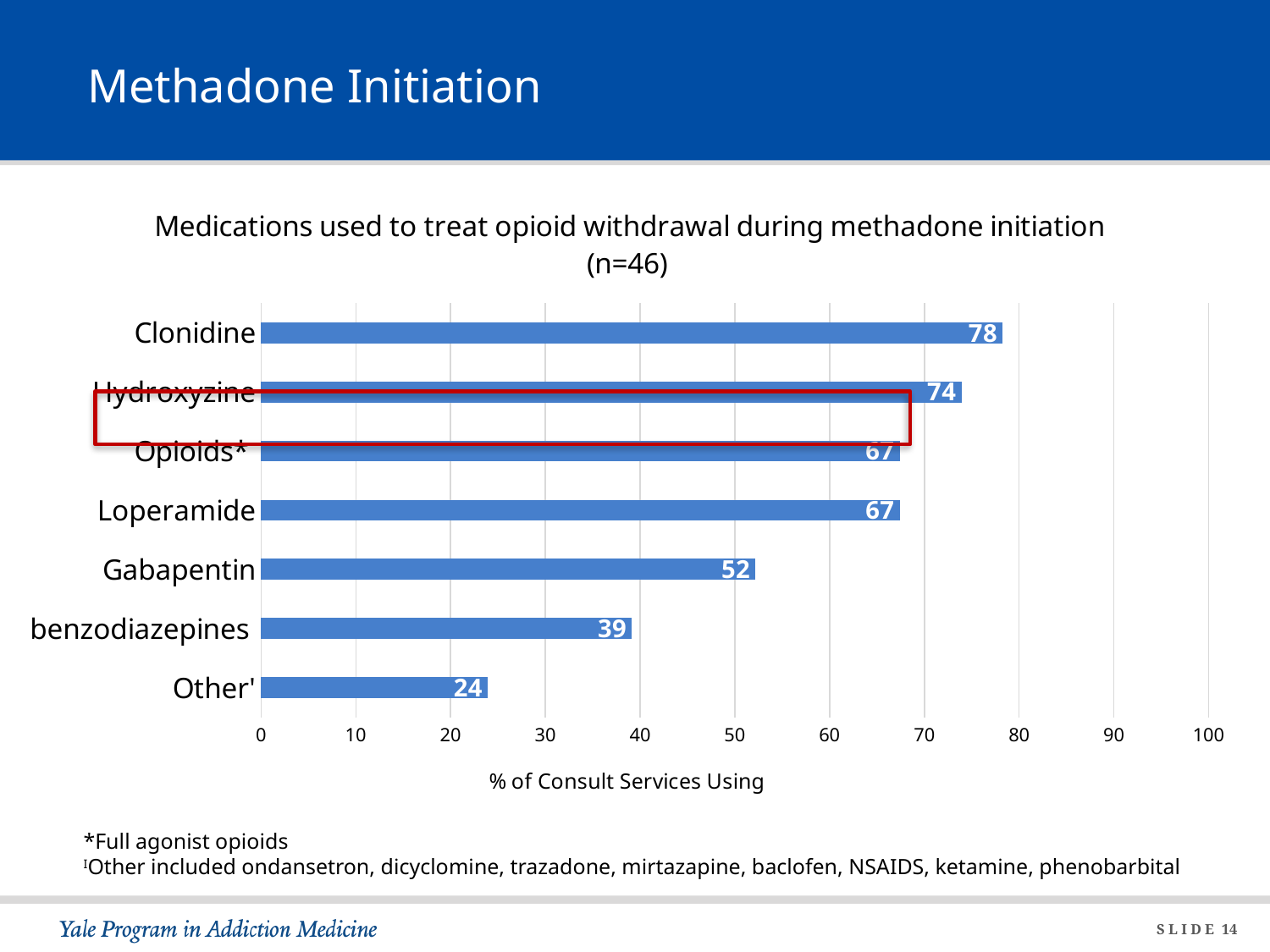
What is the value for benzodiazepines? 39 What is the value for Gabapentin? 52 Which is larger, the value for Hydroxyzine or the value for Loperamide? Hydroxyzine What is the value for Loperamide? 67 Which category has the lowest value? Other' What kind of chart is shown on the slide? Bar chart What is the value for Clonidine? 78 What is the difference between the values for Clonidine and Hydroxyzine? 4 What is the difference between the values for Gabapentin and benzodiazepines? 13 How many medication categories are shown in the chart? 7 What is the label of the x axis? % of Consult Services Using Which medication has the highest value? Clonidine